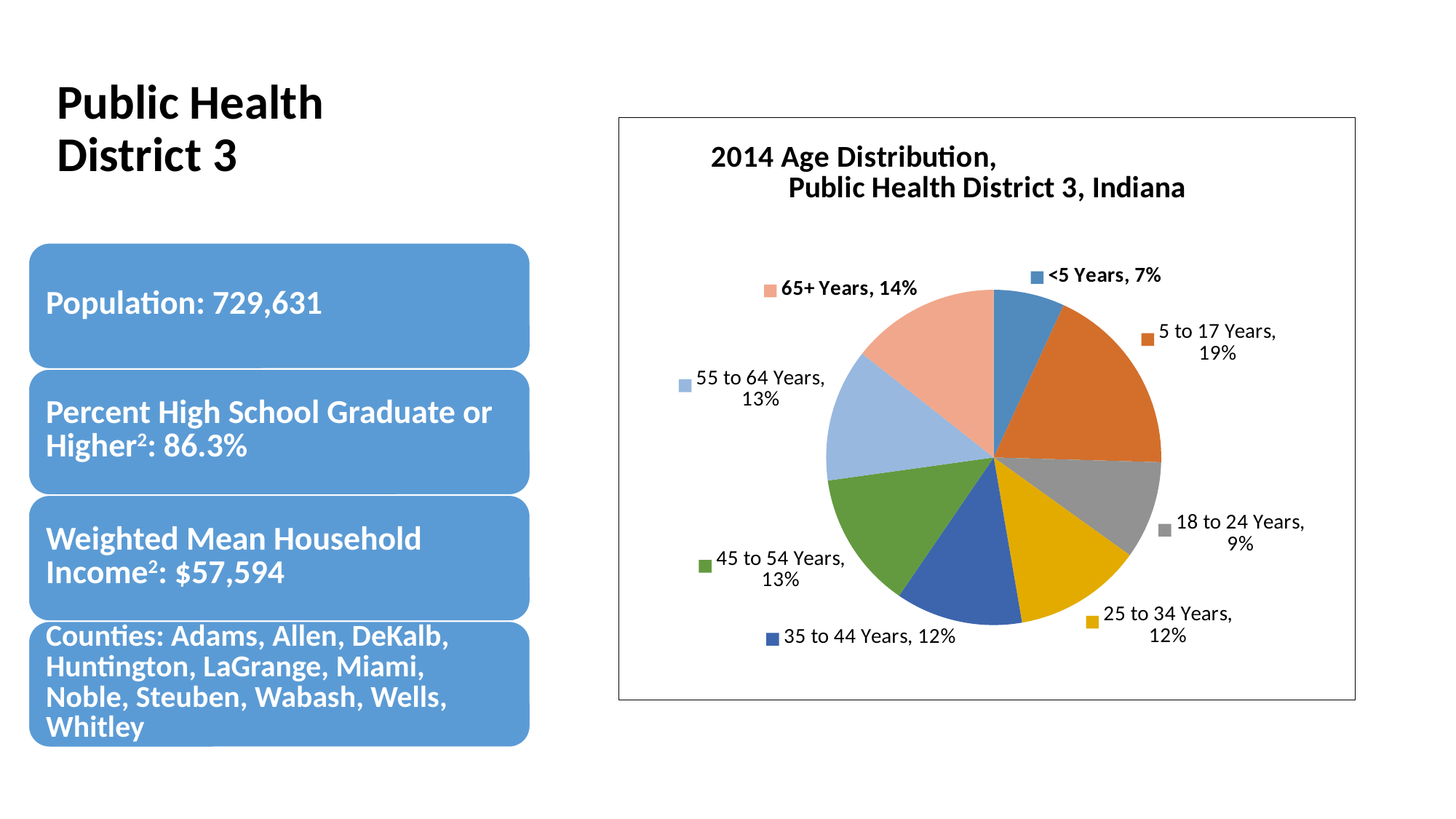
Which age group has the largest share of the pie? 5 to 17 Years What is the combined share of the 35 to 44 Years and 45 to 54 Years groups? 25% What percentage of the population is in the 5 to 17 Years group? 19% What is the difference in percentage points between the 5 to 17 Years group and the 18 to 24 Years group? 10 Which is larger, the share for 65+ Years or the share for 55 to 64 Years? 65+ Years What percentage of the population is in the 18 to 24 Years group? 9% What percentage of the population is in the 65+ Years group? 14% What percentage of the population is in the <5 Years group? 7% What is the title of the chart? 2014 Age Distribution, Public Health District 3, Indiana How many age groups are shown in the pie chart? 8 Which age group has the smallest share of the pie? <5 Years What type of chart is shown on the slide? Pie chart